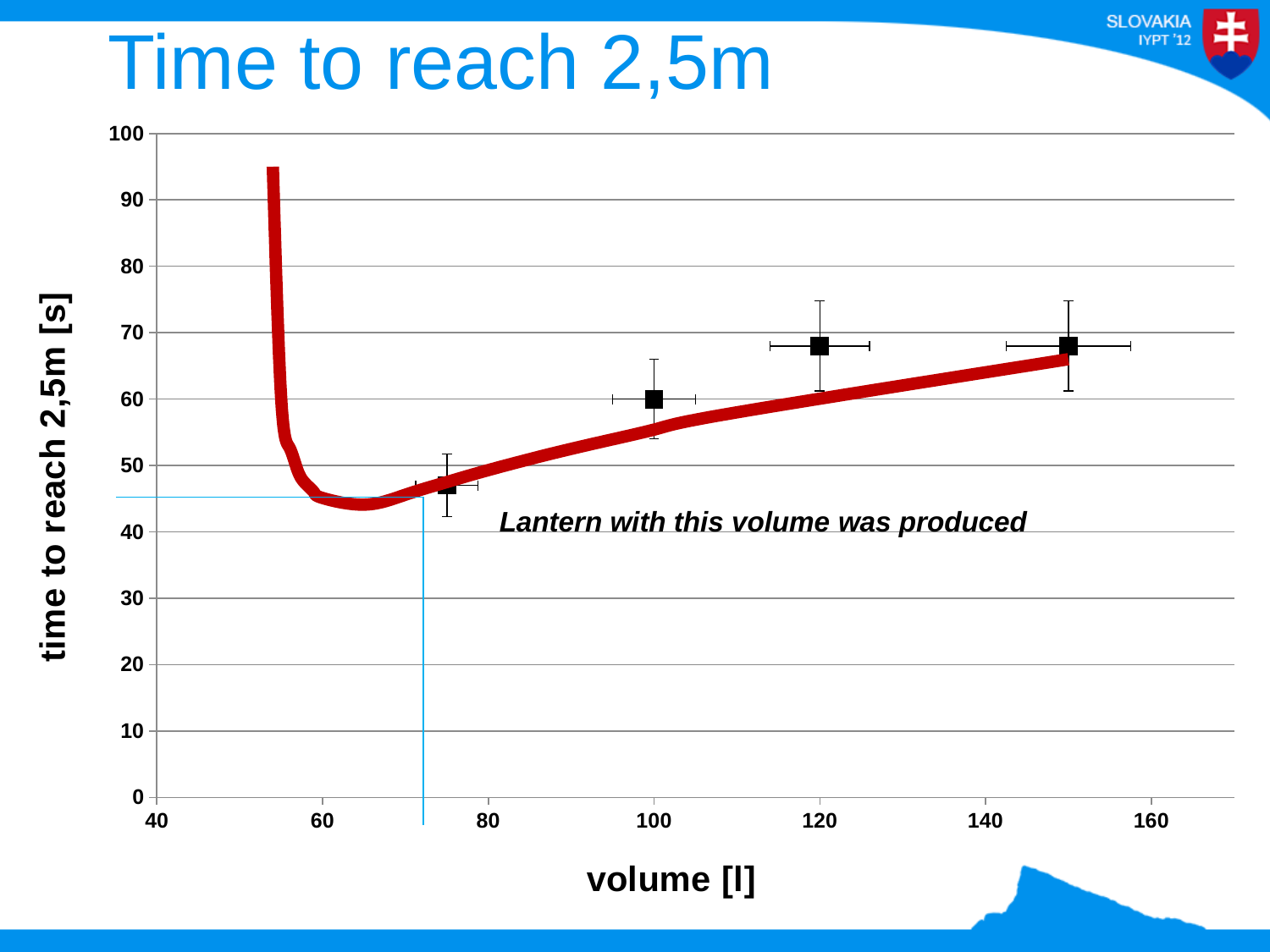
What is the label of the x axis? volume [l] Which data point has a larger time to reach 2,5m: the one at 100 l or the one at 120 l? 120 l How many measured data points (black squares) are plotted on the chart? 4 What is the label of the y axis? time to reach 2,5m [s] What is the highest value shown on the y axis? 100 Which of the plotted data points has the lowest time to reach 2,5m? The point at about 75 l Is the time to reach 2,5m for the data point at 120 l greater or less than 60 s? greater Is the time to reach 2,5m for the data point at about 75 l greater or less than 60 s? less Is the time to reach 2,5m for the data point at 150 l greater or less than 80 s? less What kind of chart is shown on the slide? Scatter chart with a fitted curve Do the measured times rise or fall as volume increases from about 75 l to 150 l? rise